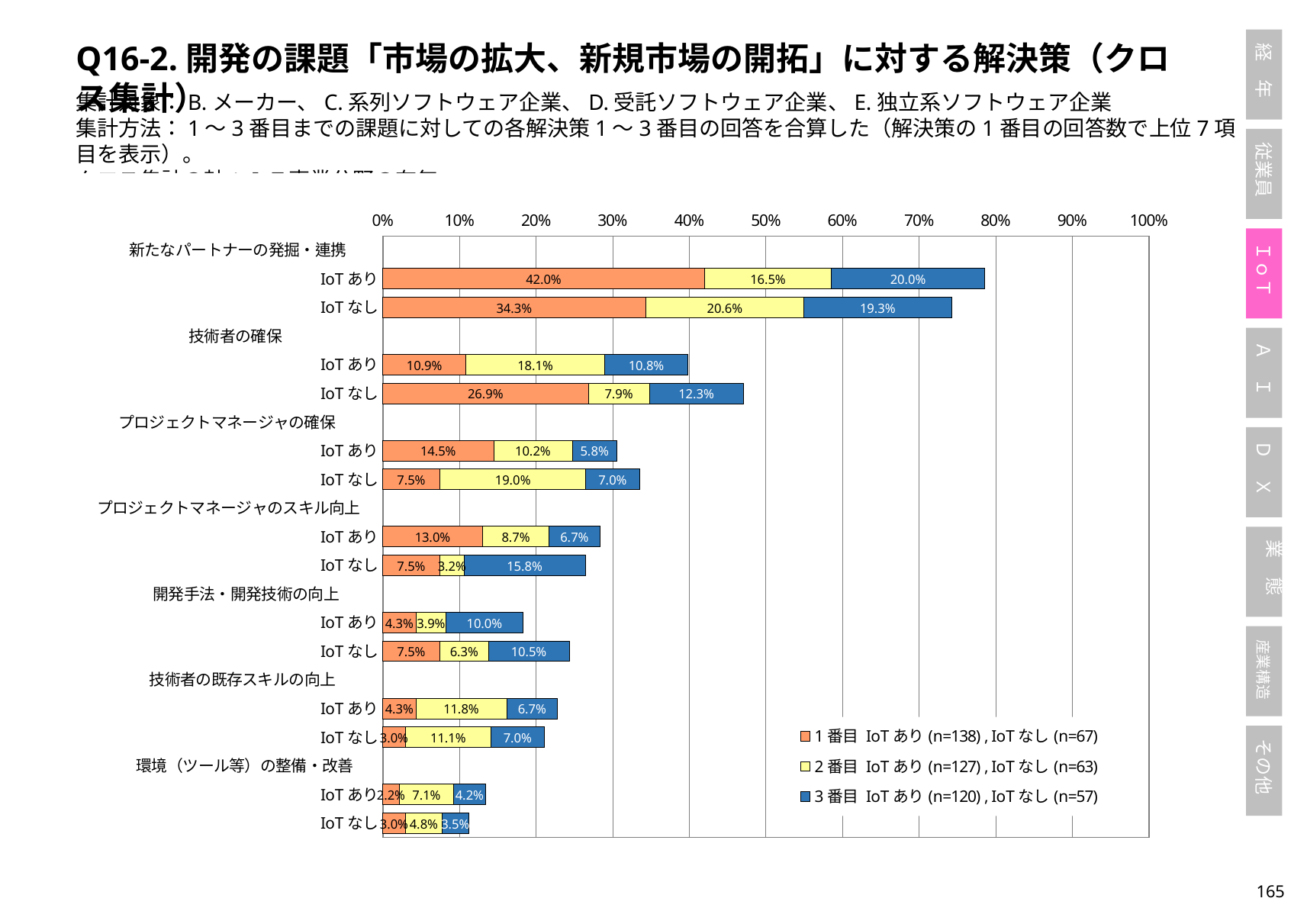
What is the 1番目 value for 技術者の確保, IoTなし? 26.9% Which solution category has the highest 1番目 value for IoTあり? 新たなパートナーの発掘・連携 Which has the larger 1番目 value for 技術者の確保: IoTあり or IoTなし? IoTなし What is the 3番目 value for プロジェクトマネージャのスキル向上, IoTなし? 15.8% What is the 1番目 value for 新たなパートナーの発掘・連携, IoTあり? 42.0% What kind of chart is shown on the slide? Stacked bar chart What is the total of the stacked bar for 新たなパートナーの発掘・連携, IoTあり? 78.5% What is the difference between the 1番目 values for 新たなパートナーの発掘・連携 IoTあり and IoTなし? 7.7% What is the sample size (n) for 1番目 IoTあり shown in the legend? 138 How many series does the legend list? 3 What is the 2番目 value for 技術者の確保, IoTあり? 18.1% What is the total of the stacked bar for 新たなパートナーの発掘・連携, IoTなし? 74.2%